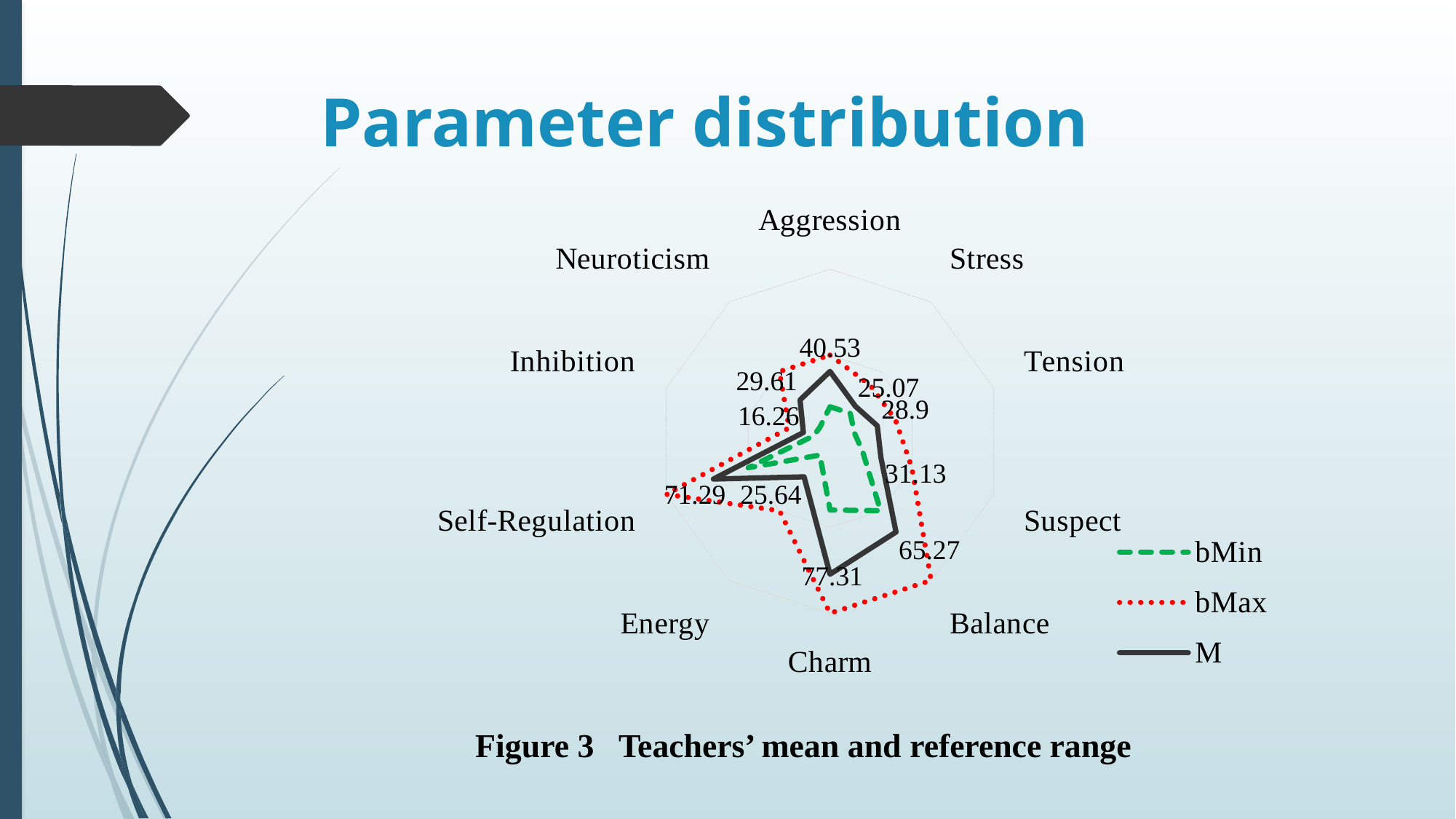
How many series does the legend list? 3 What is the M value for Aggression? 40.53 Which has a larger M value, Self-Regulation or Energy? Self-Regulation What type of chart is shown on the slide? Radar chart What is the M value for Charm? 77.31 What is the difference between the M values for Charm and Balance? 12.04 What is the M value for Self-Regulation? 71.29 How many categories (axes) does the radar chart have? 10 Which category has the highest M value? Charm What are the three series named in the legend? bMin, bMax, M What is the M value for Inhibition? 16.26 Which category has the lowest M value? Inhibition